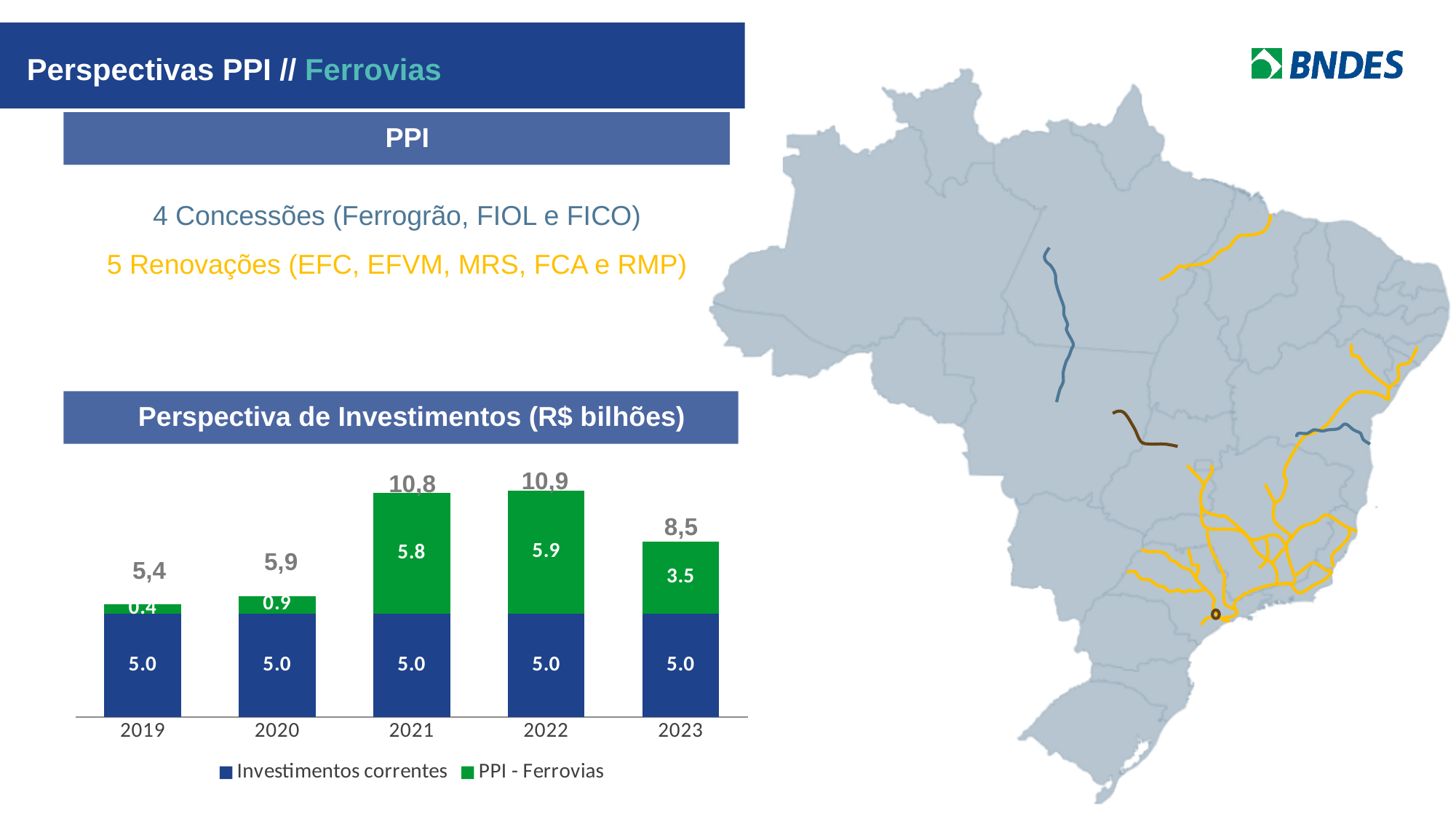
What type of chart is shown under 'Perspectiva de Investimentos (R$ bilhões)'? Stacked bar chart Does the total investment rise or fall from 2022 to 2023? Fall How many series does the legend of the investment chart list? 2 What is the value of 'PPI - Ferrovias' for 2021? 5.8 Which colour represents 'PPI - Ferrovias' in the chart? Green Which year has the highest total investment in the chart? 2022 Is the 'PPI - Ferrovias' value larger in 2020 or in 2023? 2023 What is the total shown above the bar for 2022? 10,9 How many years are shown on the x axis of the investment chart? 5 What is the value of 'Investimentos correntes' for 2023? 5.0 Which year has the lowest 'PPI - Ferrovias' value? 2019 What is the difference between the 'PPI - Ferrovias' values for 2022 and 2023? 2.4